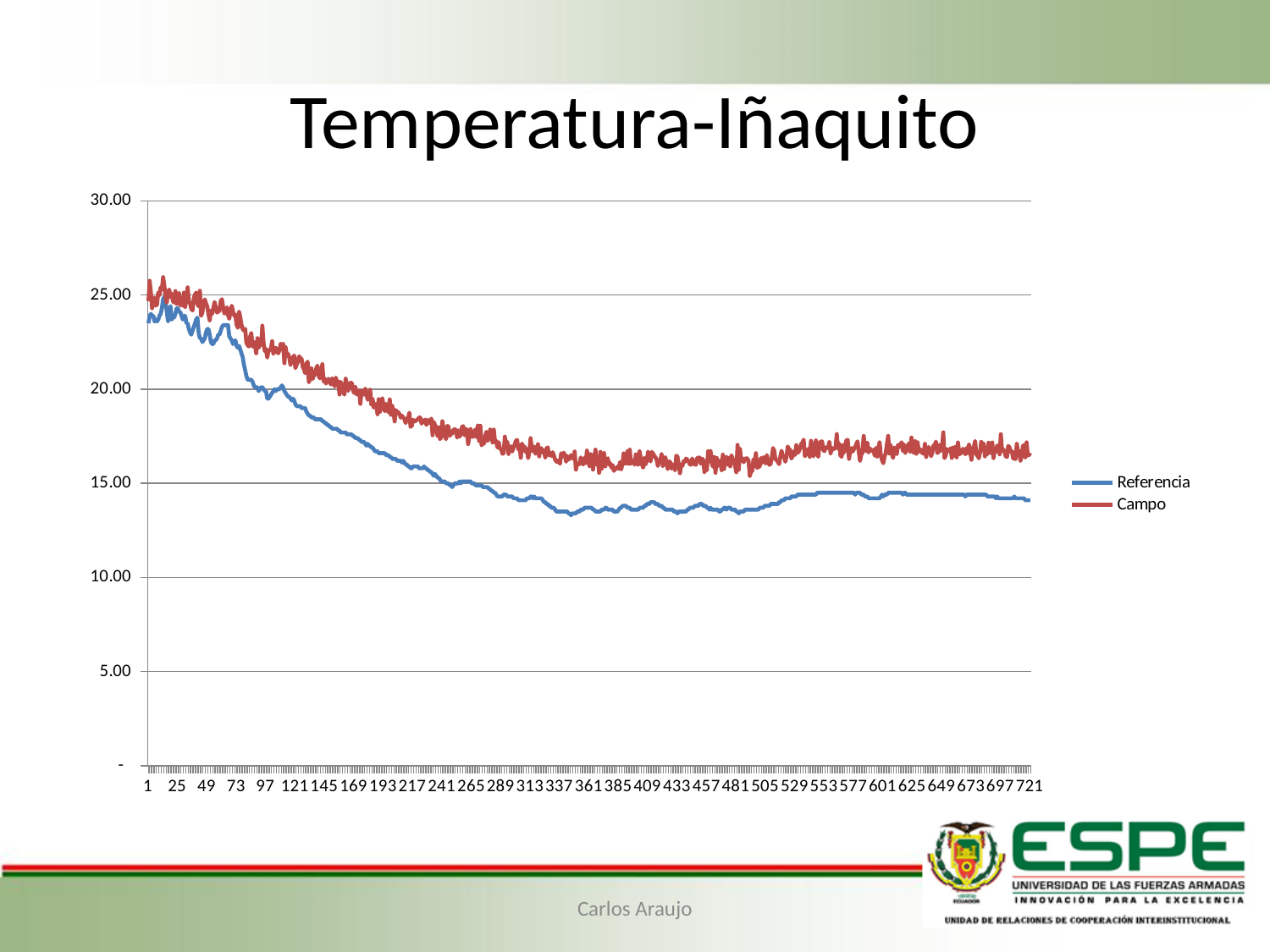
Is the value of the Campo series at x = 721 greater or less than 15.00? greater Do the values of the Referencia series rise or fall from x = 1 to x = 361? fall Which series stays higher than the other across the whole chart? Campo What is the title of the chart? Temperatura-Iñaquito Is the value of the Referencia series at x = 721 greater or less than 15.00? less What kind of chart is shown on the slide? line chart Is the value of the Referencia series at x = 1 greater or less than 20.00? greater Which series is drawn in red? Campo At x = 721, which series has the larger value, Referencia or Campo? Campo How many series does the legend list? 2